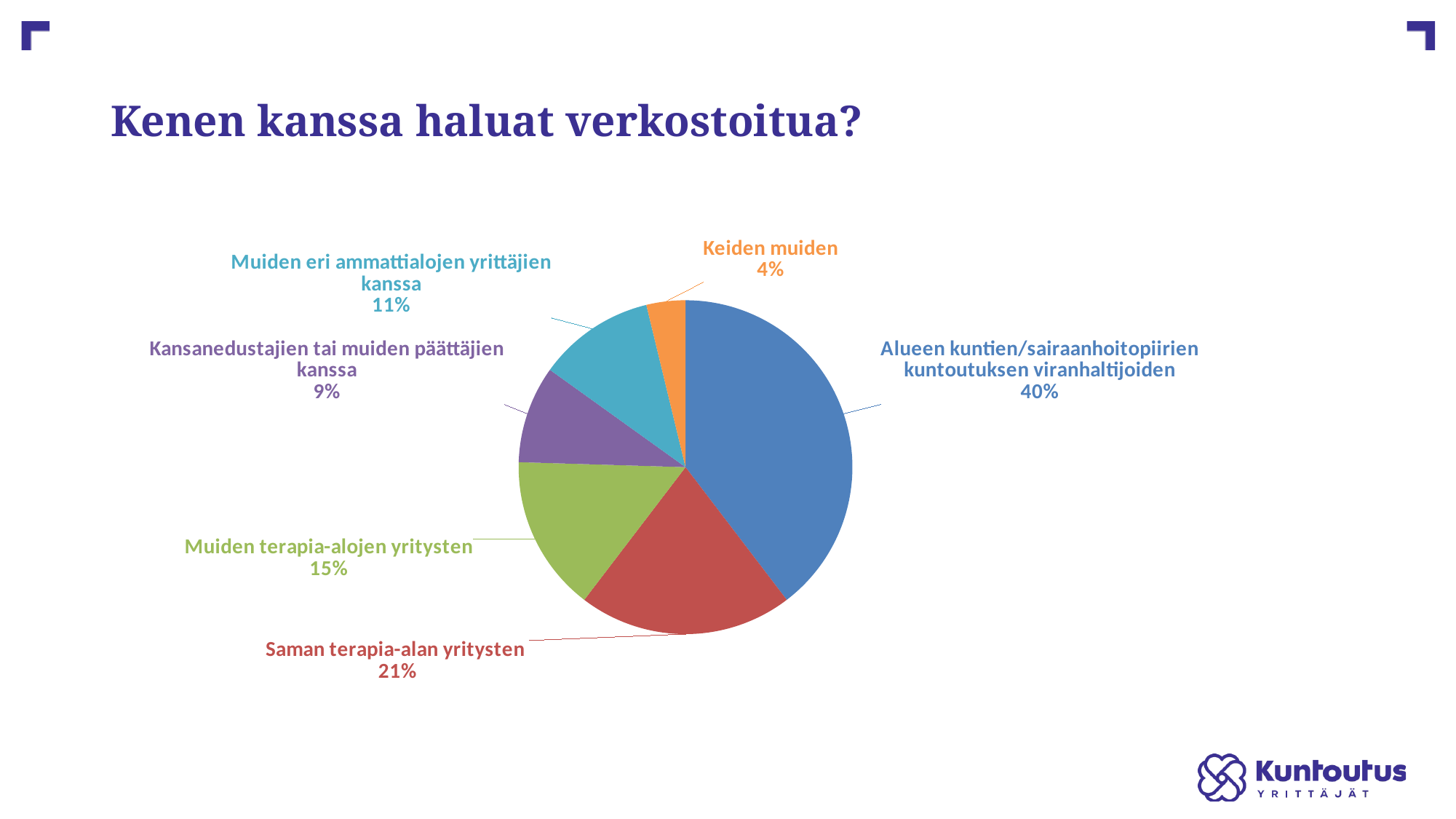
What share of the pie does "Saman terapia-alan yritysten" represent? 21% What share of the pie does "Alueen kuntien/sairaanhoitopiirien kuntoutuksen viranhaltijoiden" represent? 40% Which category has the smallest slice of the pie? Keiden muiden Which is larger: "Muiden eri ammattialojen yrittäjien kanssa" or "Kansanedustajien tai muiden päättäjien kanssa"? Muiden eri ammattialojen yrittäjien kanssa What is the value shown for "Keiden muiden"? 4% What is the value shown for "Muiden terapia-alojen yritysten"? 15% What is the difference in percentage points between "Saman terapia-alan yritysten" and "Muiden terapia-alojen yritysten"? 6 How many categories are shown in the pie chart? 6 What is the value shown for "Kansanedustajien tai muiden päättäjien kanssa"? 9% What is the title of the slide? Kenen kanssa haluat verkostoitua? What kind of chart is shown on the slide? Pie chart Which category has the largest slice of the pie? Alueen kuntien/sairaanhoitopiirien kuntoutuksen viranhaltijoiden